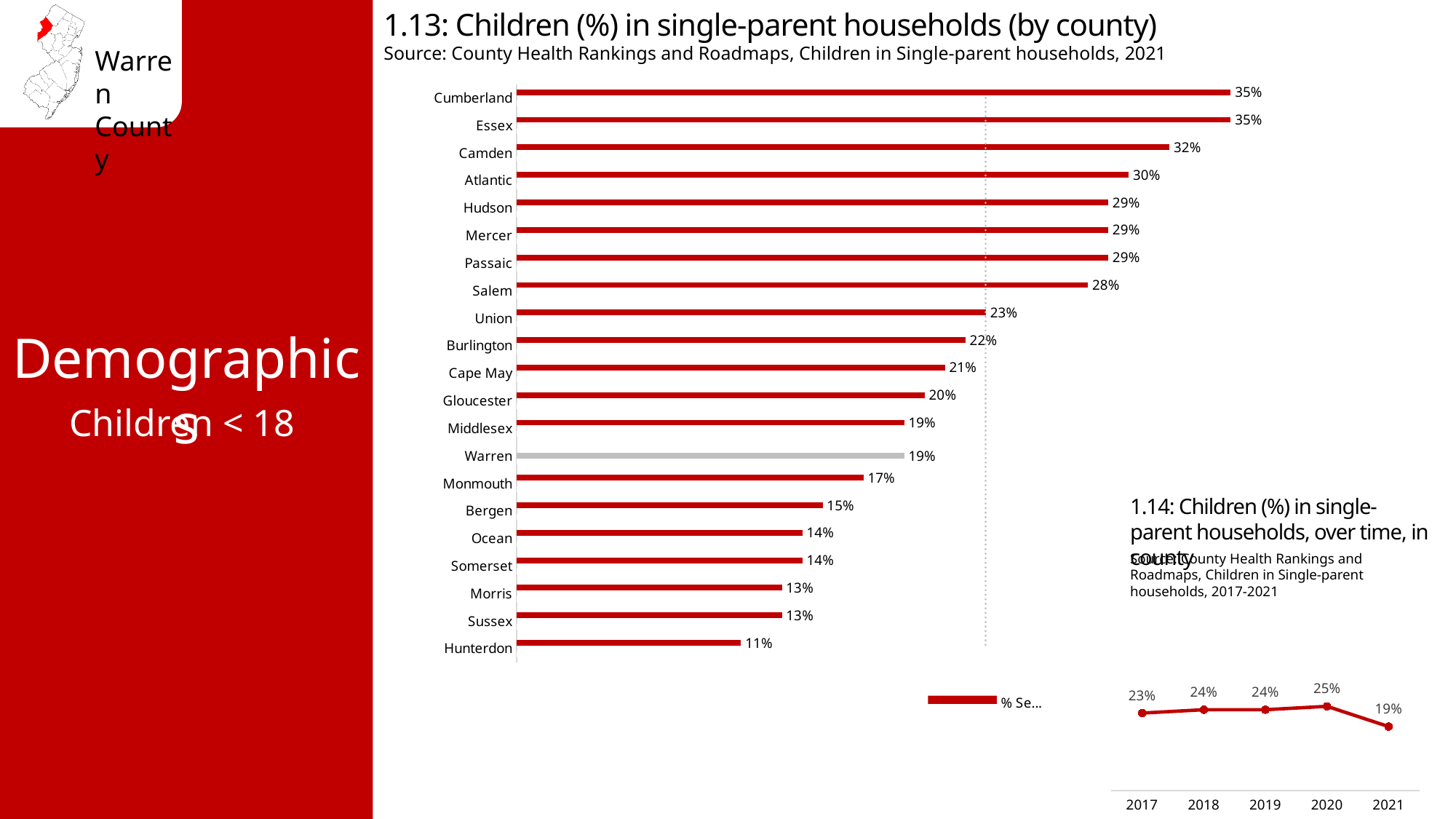
In chart 1.13, what is the difference between the values for Cumberland and Warren? 16% In chart 1.13, what is the value for Hunterdon? 11% In chart 1.13 (Children (%) in single-parent households by county), what is the value for Warren? 19% What kind of chart is chart 1.14? Line chart In chart 1.14, what is the difference between the values for 2020 and 2021? 6% In chart 1.14, which year has the lowest value? 2021 In chart 1.14 (Children (%) in single-parent households over time, in county), what is the value for 2020? 25% What kind of chart is chart 1.13? Bar chart In chart 1.13, how many counties are shown? 21 In chart 1.13, which is larger, the value for Camden or the value for Atlantic? Camden In chart 1.13, what is the value for Salem? 28% In chart 1.13, which county has the lowest percentage of children in single-parent households? Hunterdon